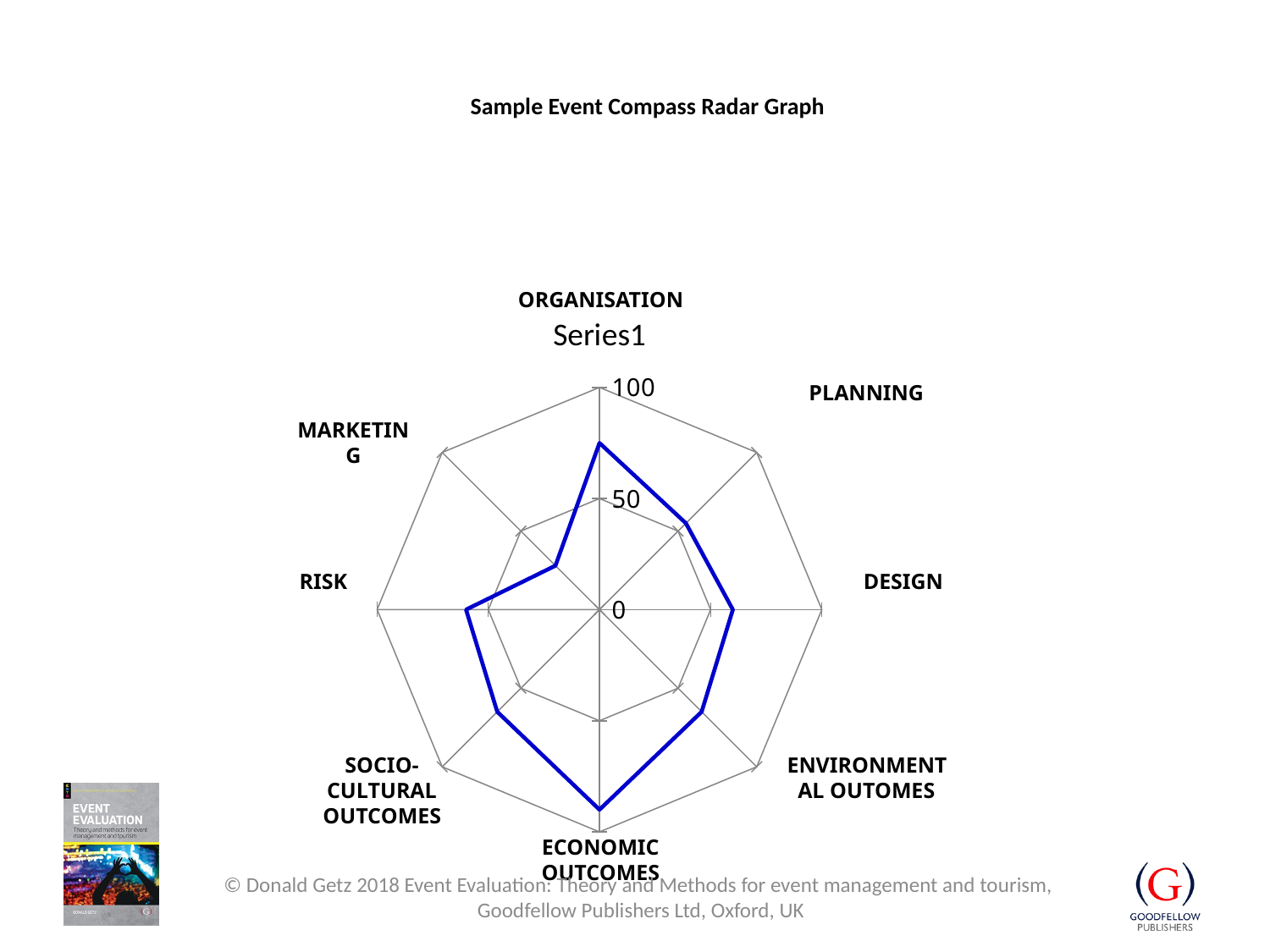
Which category has the highest value on the radar chart? Economic Outcomes Is the value for Economic Outcomes greater or less than 50? greater Is the value for Marketing greater or less than 50? less How many categories (axes) does the radar chart have? 8 Which category has the lowest value on the radar chart? Marketing How many data series are plotted on the radar chart? 1 What is the maximum value shown on the radar chart's axis scale? 100 Which is larger, the value for Organisation or the value for Marketing? Organisation Which is larger, the value for Economic Outcomes or the value for Marketing? Economic Outcomes Is the value for Socio-Cultural Outcomes greater or less than 50? greater What kind of chart is shown on the slide? Radar chart